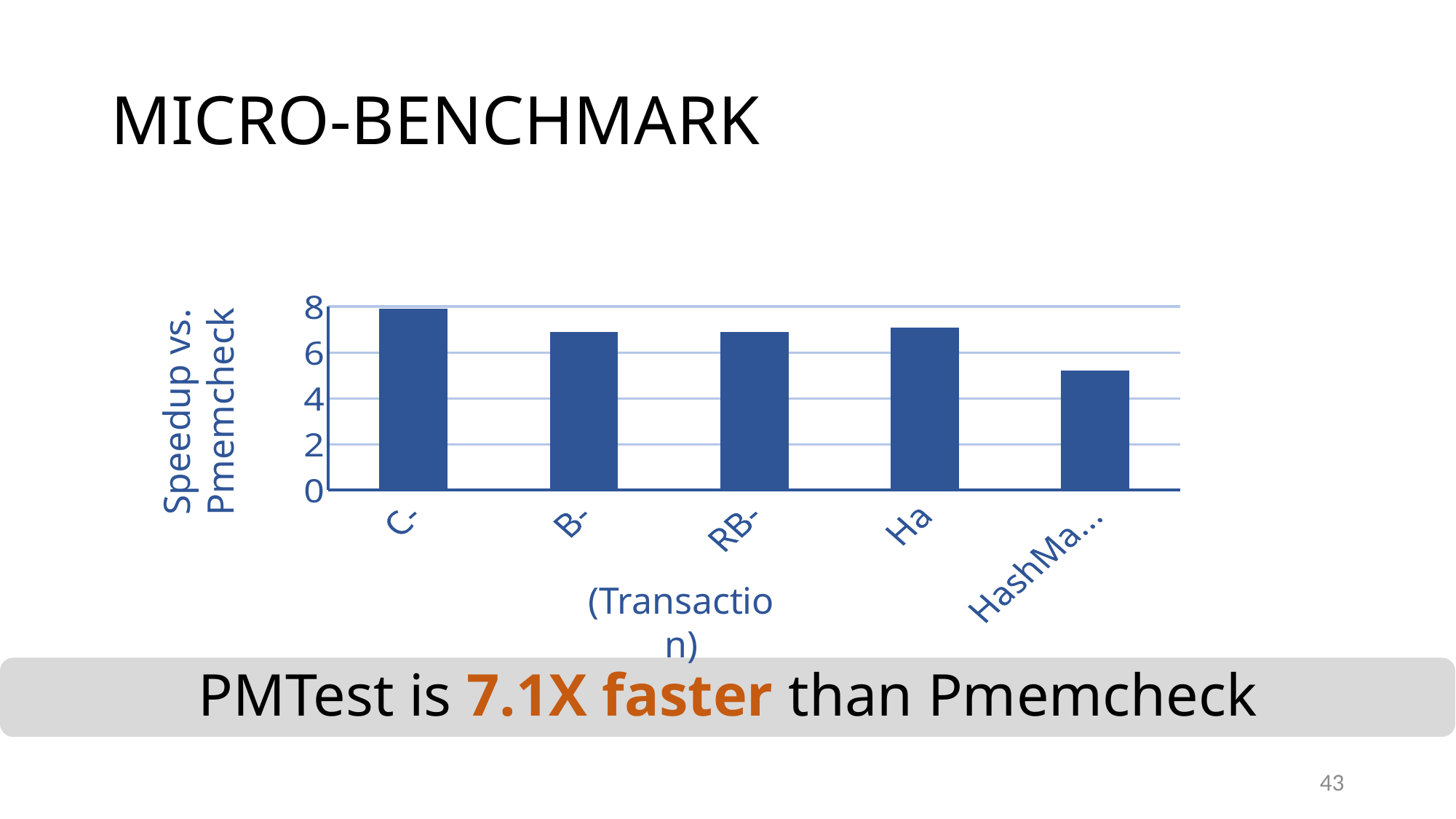
What is the title of the vertical axis of the chart? Speedup vs. Pmemcheck Is the value for the bar labelled RB- greater or less than 8? less Is the value for the last bar (HashMa...) greater or less than 6? less How many bars are plotted in the chart? 5 Which bar in the chart is the highest? C- (the first bar) Is the value for the first bar (C-) greater or less than 6? greater Which bar in the chart is the lowest? HashMa... (the last bar) Which is larger, the value for Ha or the value for HashMa...? Ha Which is larger, the value for C- or the value for HashMa...? C- What kind of chart is shown on the slide? bar chart What is the highest tick value shown on the vertical axis? 8